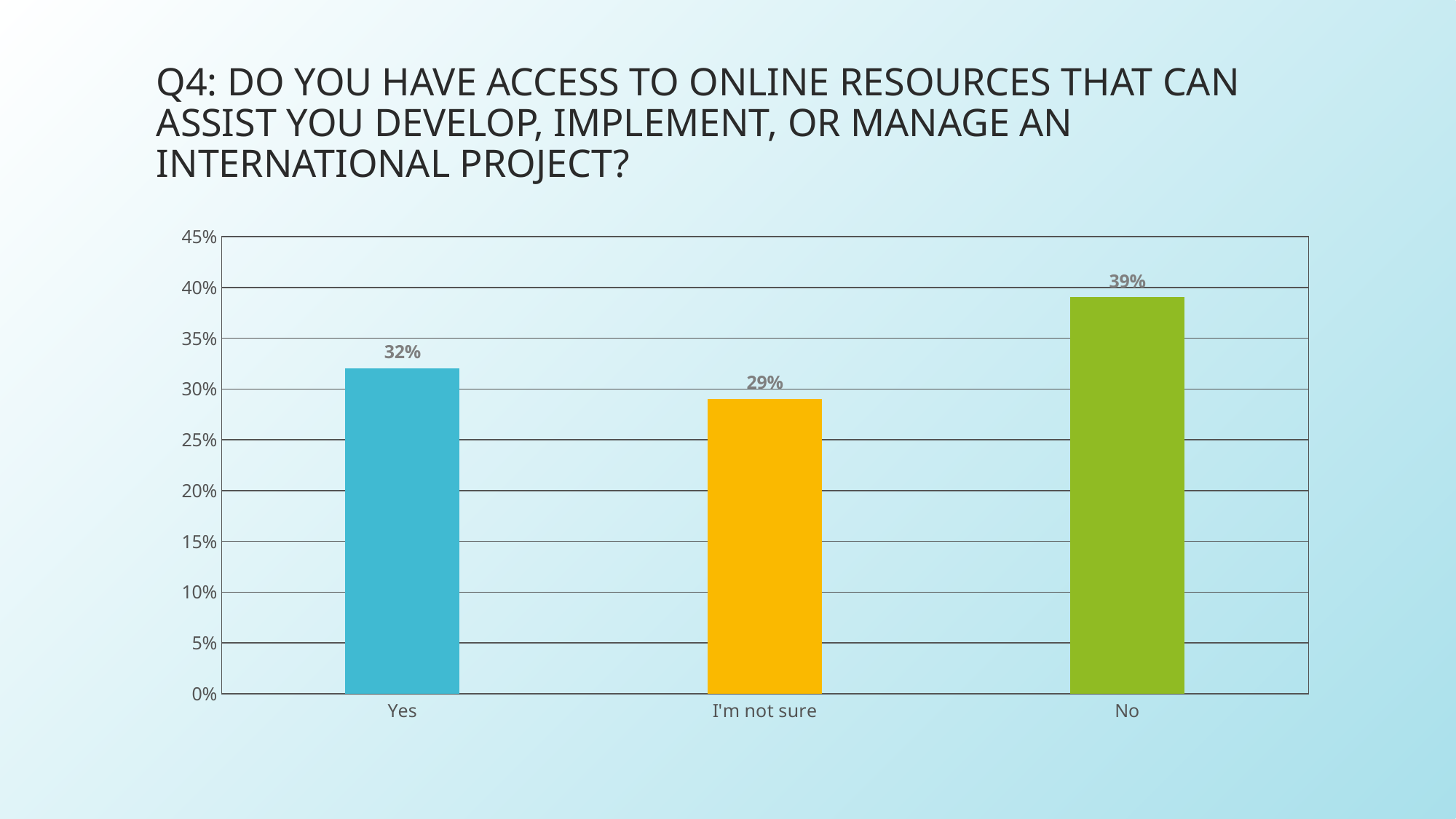
Is the value for "I'm not sure" greater or less than 30%? less What colour is the bar for "No"? Green What is the difference in percentage points between "No" and "Yes"? 7 What kind of chart is shown on the slide? Bar chart Which response category has the lowest percentage? I'm not sure What percentage of respondents answered "Yes"? 32% What percentage of respondents answered "I'm not sure"? 29% What is the difference in percentage points between "Yes" and "I'm not sure"? 3 Which response category has the highest percentage? No What percentage of respondents answered "No"? 39% How many response categories are shown on the x axis? 3 Which is larger, the value for "Yes" or the value for "No"? No